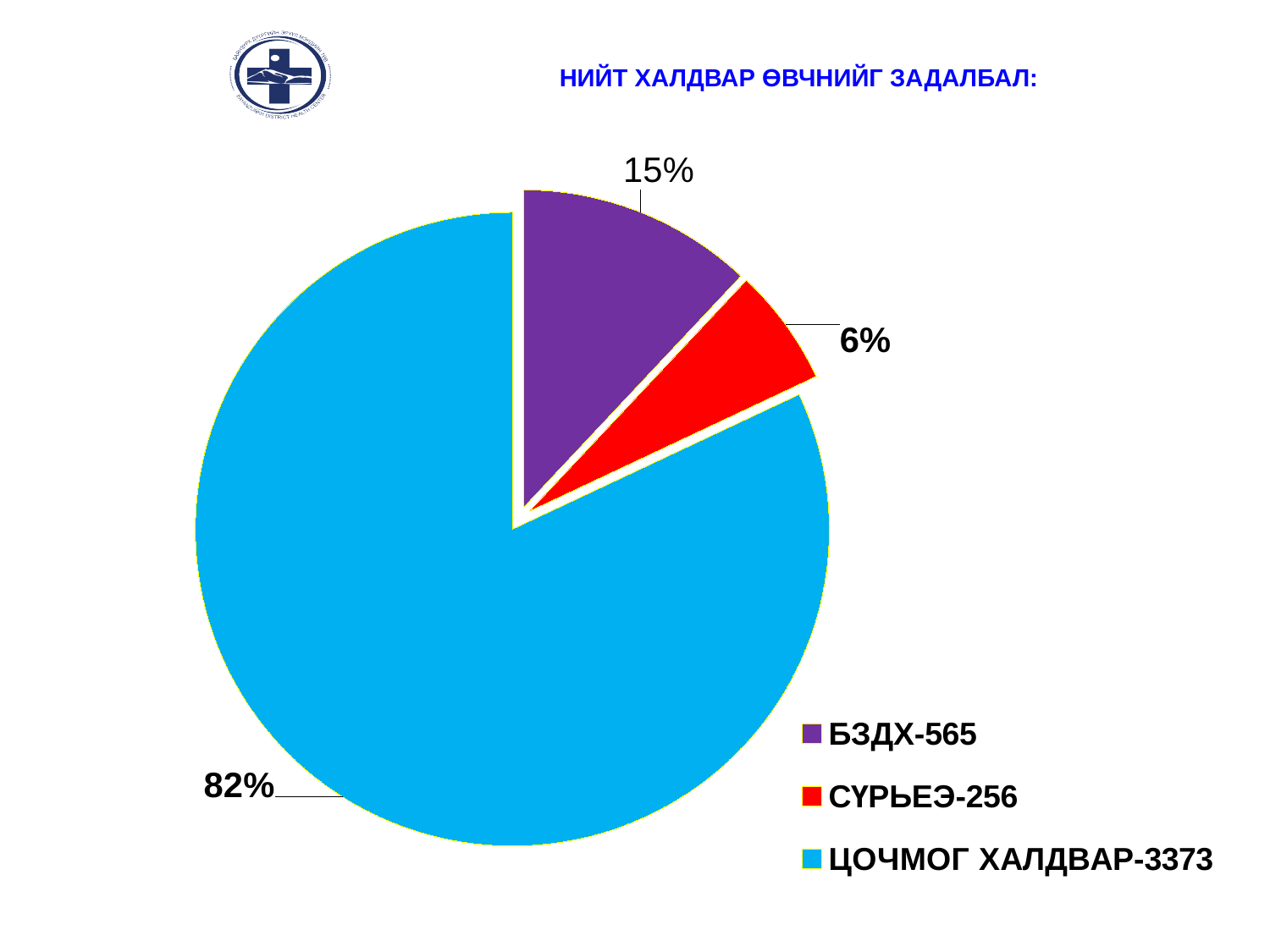
What kind of chart is shown on the slide? pie chart What is the difference in percentage points between the ЦОЧМОГ ХАЛДВАР-3373 slice and the БЗДХ-565 slice? 67% What percentage share is shown for the ЦОЧМОГ ХАЛДВАР-3373 slice? 82% How many entries does the legend list? 3 What colour is the ЦОЧМОГ ХАЛДВАР-3373 slice? blue Which slice is larger, БЗДХ-565 or СҮРЬЕЭ-256? БЗДХ-565 Which slice is the smallest in the pie chart? СҮРЬЕЭ-256 What percentage share is shown for the СҮРЬЕЭ-256 slice? 6% Which slice is the largest in the pie chart? ЦОЧМОГ ХАЛДВАР-3373 What is the title of the chart? НИЙТ ХАЛДВАР ӨВЧНИЙГ ЗАДАЛБАЛ: What percentage share is shown for the БЗДХ-565 slice? 15% How many slices does the pie chart have? 3